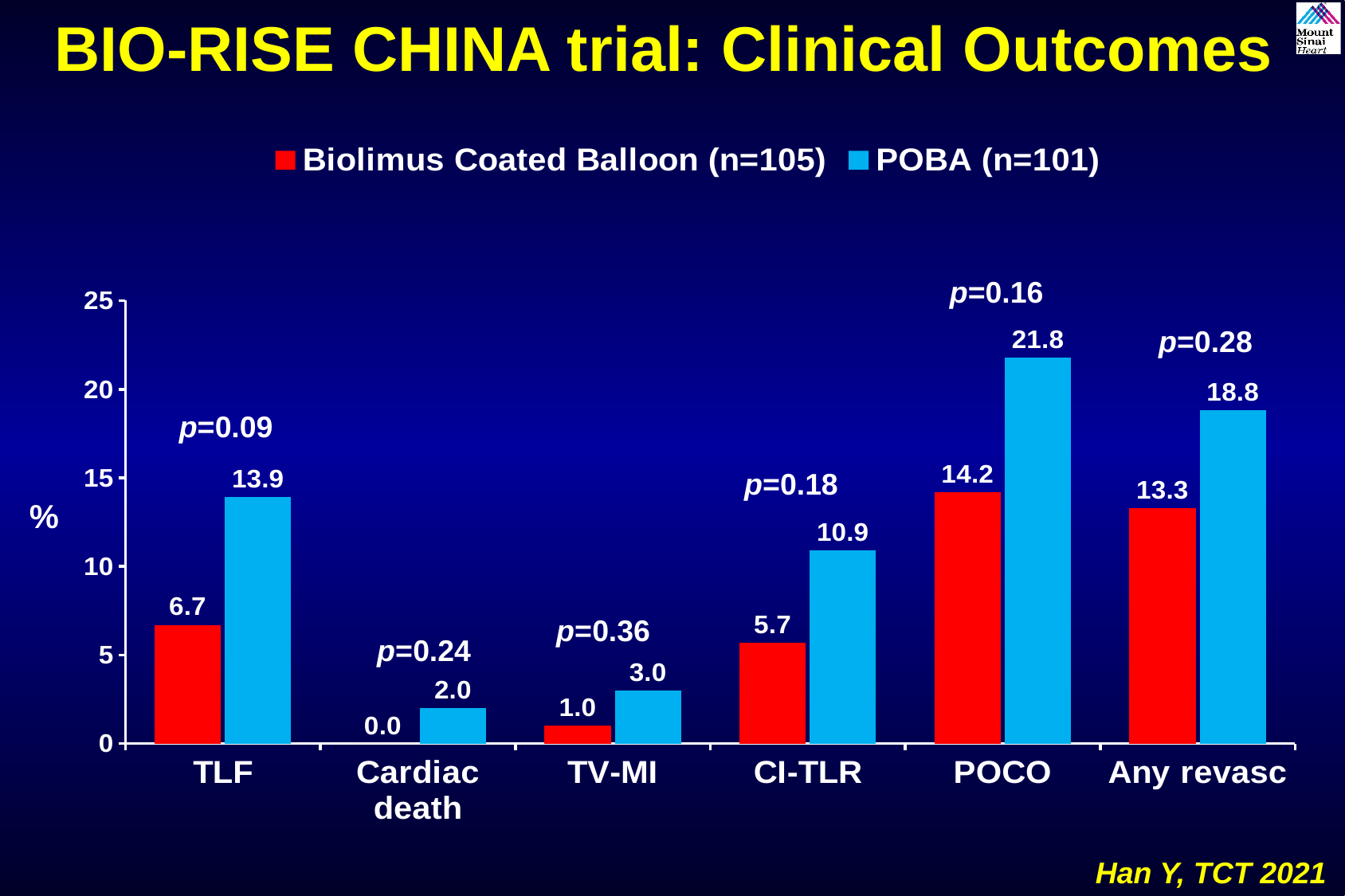
Which outcome category has the lowest value for the Biolimus Coated Balloon group? Cardiac death What p-value is shown above the TLF bars? p=0.09 What kind of chart is shown on the slide? Bar chart What is the difference between the POBA and Biolimus Coated Balloon values for Any revasc? 5.5 Which outcome category has the highest value for the POBA group? POCO How many series does the legend list? 2 How many outcome categories are shown on the x axis? 6 What is the TLF value for the Biolimus Coated Balloon group? 6.7 For CI-TLR, which group has the larger value, Biolimus Coated Balloon or POBA? POBA What is the Cardiac death value for the Biolimus Coated Balloon group? 0.0 What colour are the POBA bars? Blue What is the POCO value for the POBA group? 21.8